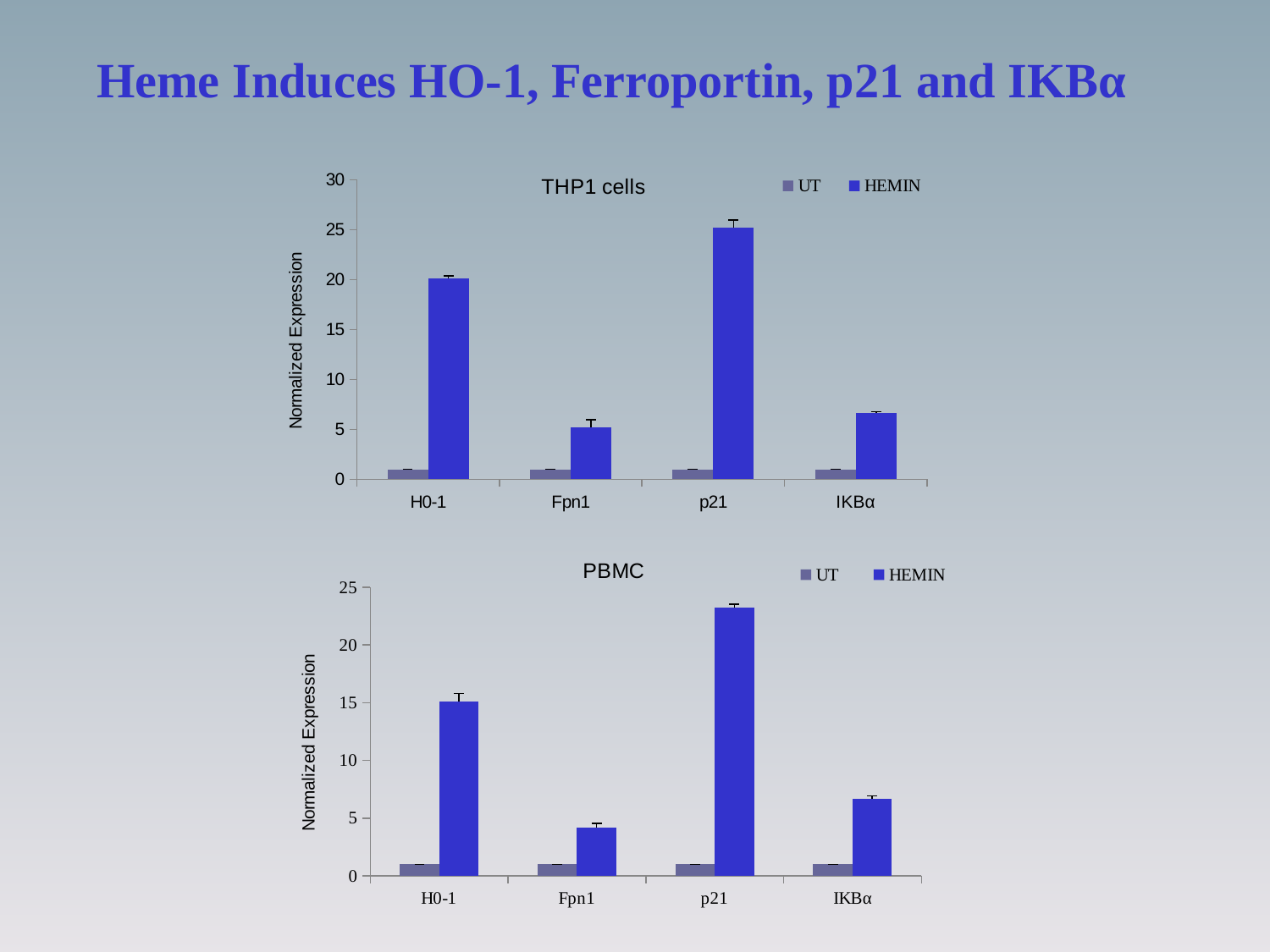
In the PBMC chart, what is the label of the y axis? Normalized Expression In the PBMC chart, how many categories are shown on the x axis? 4 In the THP1 cells chart, which category has the lowest HEMIN value? Fpn1 In the THP1 cells chart, which category has the highest HEMIN value? p21 In the PBMC chart, which category has the lowest HEMIN value? Fpn1 In the THP1 cells chart, what kind of chart is shown? bar chart In the THP1 cells chart, is the HEMIN value for p21 greater or less than 20? greater In the PBMC chart, which category has the highest HEMIN value? p21 In the THP1 cells chart, is the HEMIN value for Fpn1 greater or less than 10? less In the THP1 cells chart, how many series does the legend list? 2 In the PBMC chart, which is larger, the HEMIN value for H0-1 or the HEMIN value for IKBα? H0-1 In the PBMC chart, is the HEMIN value for H0-1 greater or less than 10? greater